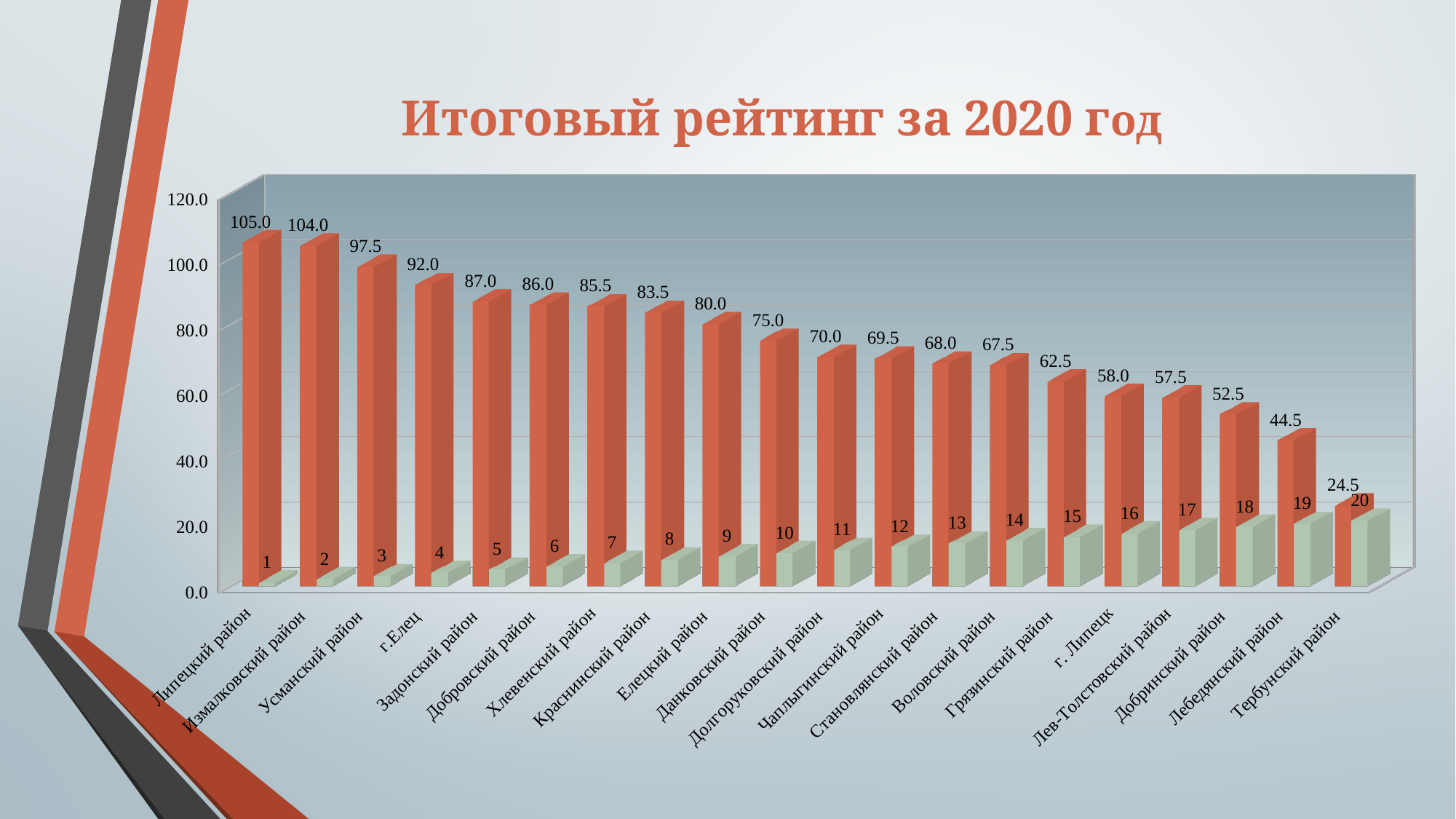
Which district has the highest rating value? Липецкий район What is the difference between the rating values of Липецкий район and Тербунский район? 80.5 Which district has the lowest rating value? Тербунский район What is the difference between the rating values of г.Елец and Елецкий район? 12.0 What type of chart is shown on the slide? bar chart Which has a higher rating value, Задонский район or Грязинский район? Задонский район What rank number is shown for Данковский район? 10 What is the title of the chart? Итоговый рейтинг за 2020 год What is the rating value for г. Липецк? 58.0 How many categories (districts) are shown on the x axis? 20 Do the rating values rise or fall from left to right along the x axis? fall What is the rating value for Усманский район? 97.5